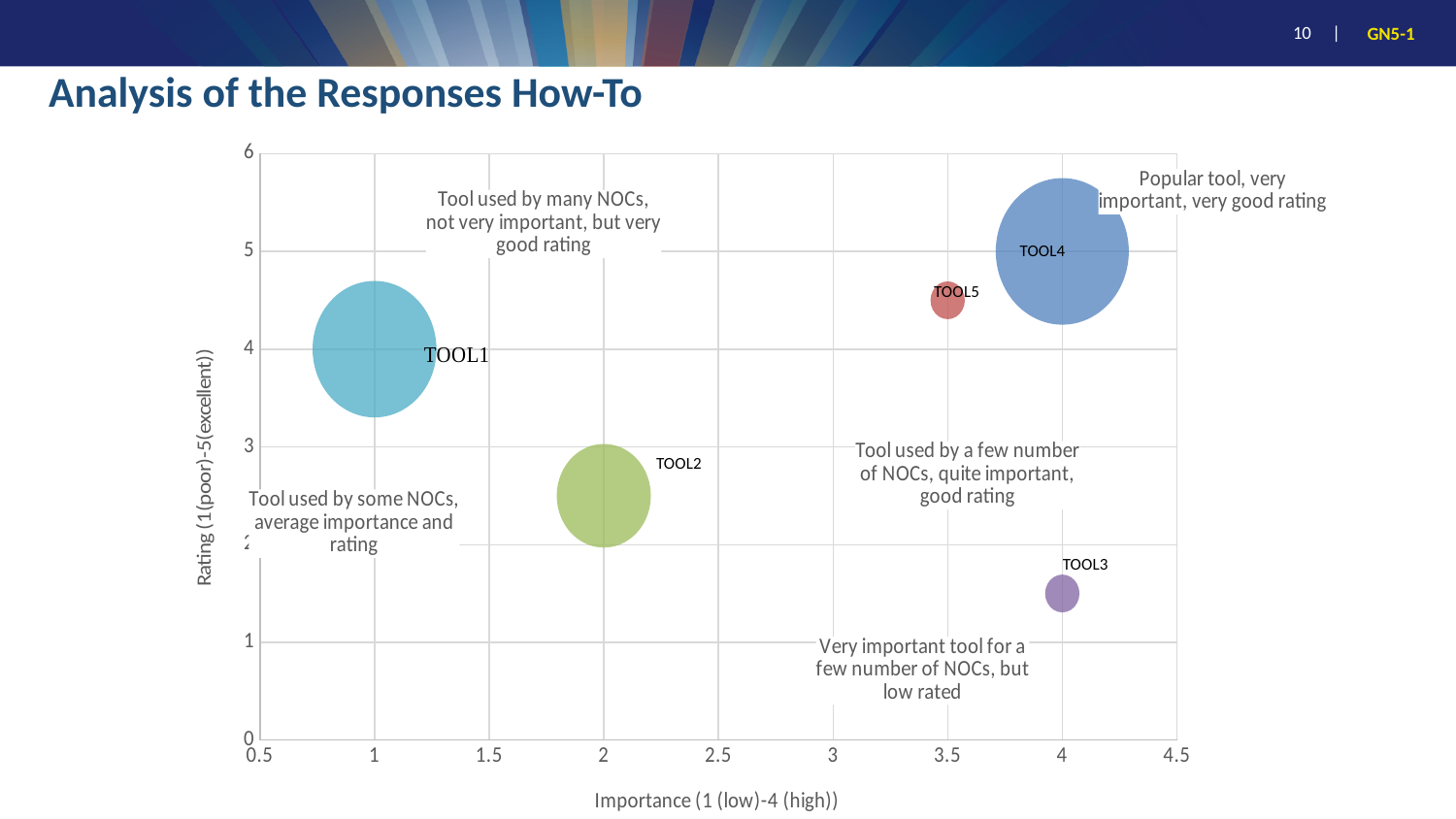
What is the importance value for TOOL1? 1 Which tool has the highest rating? TOOL4 What is the title of the horizontal axis? Importance (1 (low)-4 (high)) Which tool has the lowest rating? TOOL3 What type of chart is shown on the slide? Bubble chart Is the rating for TOOL3 greater or less than 2? less What is the rating value for TOOL4? 5 What is the rating value for TOOL1? 4 How many tools are plotted as bubbles in the chart? 5 What is the importance value for TOOL5? 3.5 What is the importance value for TOOL2? 2 Which tool has a higher rating, TOOL2 or TOOL5? TOOL5